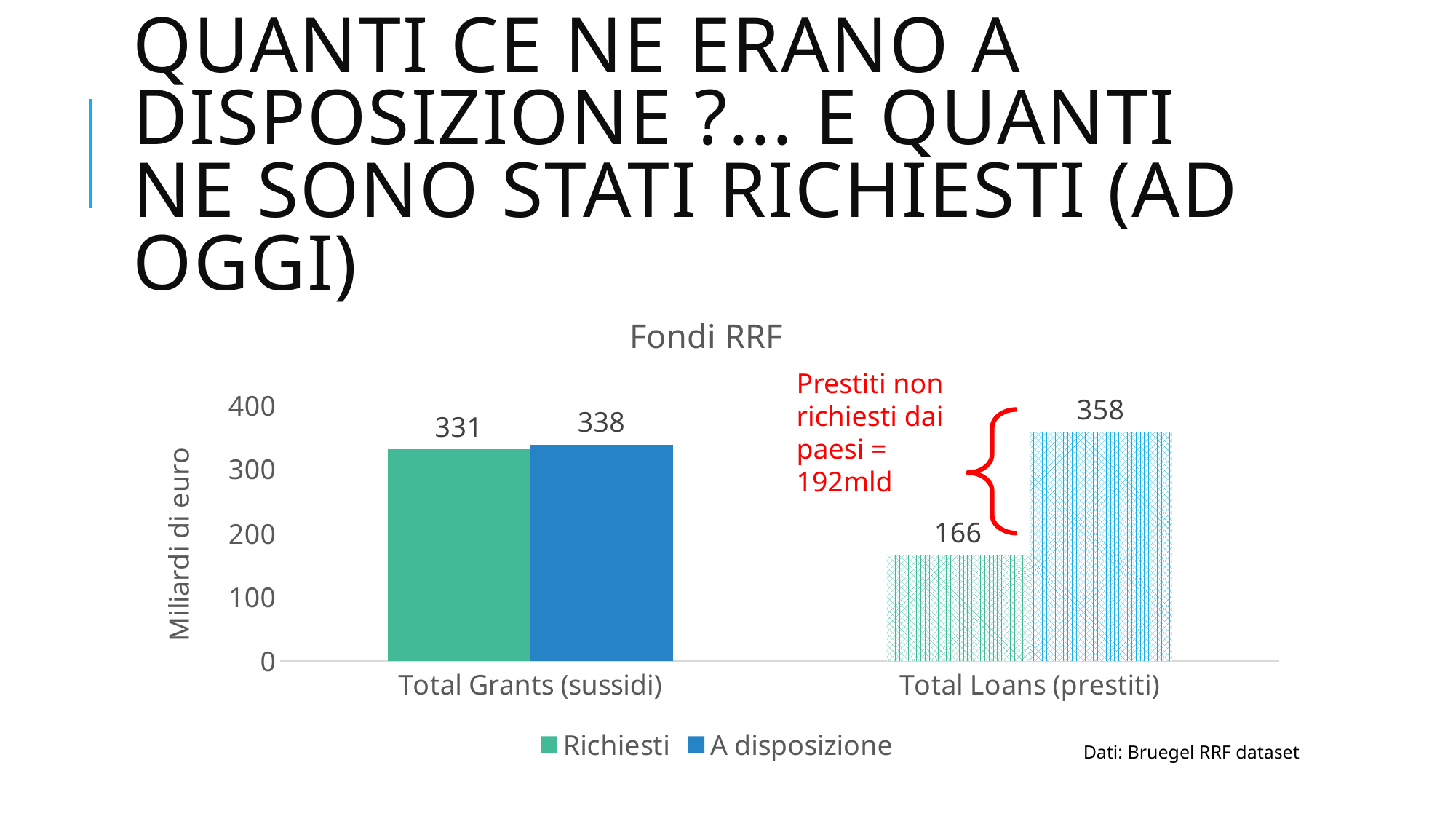
What is the value of A disposizione for Total Loans (prestiti)? 358 What is the difference between A disposizione and Richiesti for Total Grants (sussidi)? 7 Which category has the lowest Richiesti value? Total Loans (prestiti) How many series does the legend list? 2 What is the value of Richiesti for Total Grants (sussidi)? 331 What is the value of Richiesti for Total Loans (prestiti)? 166 What is the title of the chart? Fondi RRF Which category has the highest A disposizione value? Total Loans (prestiti) What is the difference between A disposizione and Richiesti for Total Loans (prestiti)? 192 What kind of chart is shown on the slide? Bar chart Which is larger: Richiesti for Total Grants (sussidi) or Richiesti for Total Loans (prestiti)? Total Grants (sussidi) What is the value of A disposizione for Total Grants (sussidi)? 338